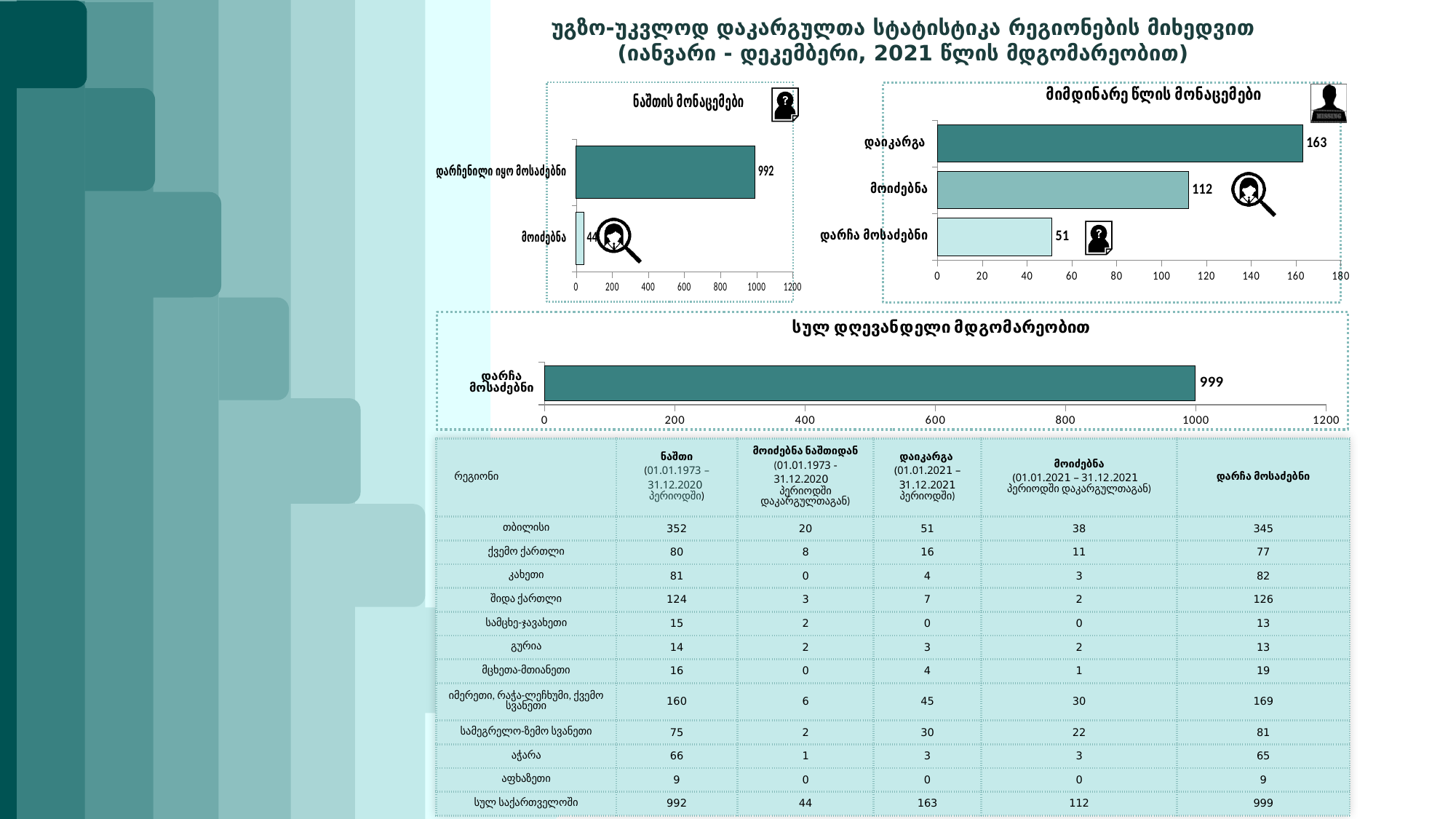
In the top-right chart titled "მიმდინარე წლის მონაცემები", what is the value for "მოიძებნა"? 112 In the top-left chart titled "ნაშთის მონაცემები", what is the value for "მოიძებნა"? 44 In the top-left chart titled "ნაშთის მონაცემები", is the value for "მოიძებნა" greater or less than 200? less In the top-right chart titled "მიმდინარე წლის მონაცემები", which category has the highest value? დაიკარგა In the top-right chart titled "მიმდინარე წლის მონაცემები", what is the value for "დაიკარგა"? 163 In the top-right chart titled "მიმდინარე წლის მონაცემები", what is the difference between the values for "დაიკარგა" and "მოიძებნა"? 51 In the top-right chart titled "მიმდინარე წლის მონაცემები", how many categories are plotted? 3 In the top-left chart titled "ნაშთის მონაცემები", what is the value for "დარჩენილი იყო მოსაძებნი"? 992 In the top-left chart titled "ნაშთის მონაცემები", what is the difference between the values for "დარჩენილი იყო მოსაძებნი" and "მოიძებნა"? 948 In the bottom chart titled "სულ დღევანდელი მდგომარეობით", what is the value for "დარჩა მოსაძებნი"? 999 In the top-right chart titled "მიმდინარე წლის მონაცემები", which category has the lowest value? დარჩა მოსაძებნი What kind of chart is the bottom chart titled "სულ დღევანდელი მდგომარეობით"? bar chart